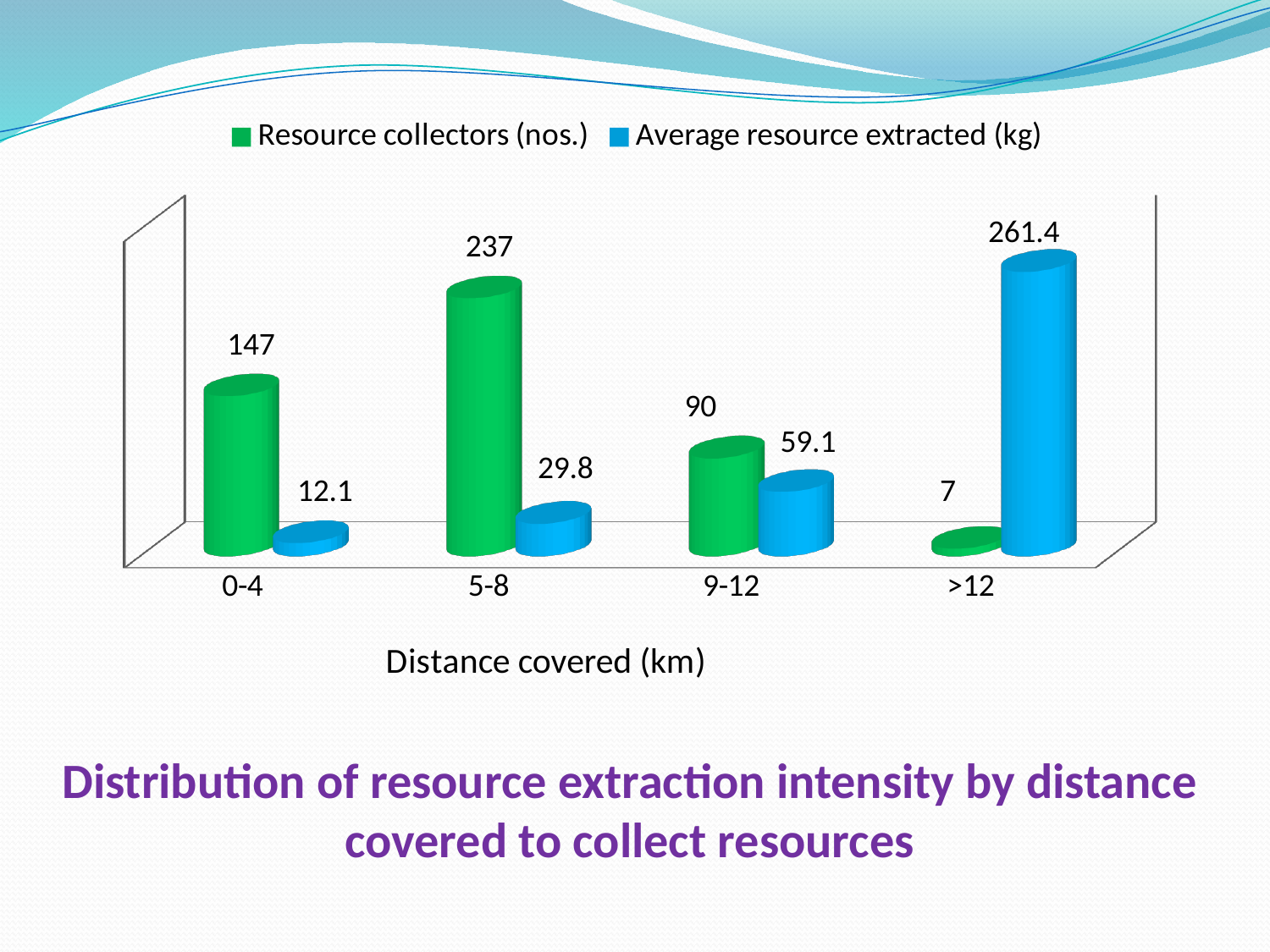
What kind of chart is shown on the slide? Bar chart What is the difference in the number of resource collectors between the 5-8 km and 0-4 km categories? 90 What is the average resource extracted (kg) for the >12 km distance category? 261.4 How many resource collectors are there for the 5-8 km distance category? 237 How many series does the legend list? 2 What is the average resource extracted (kg) for the 0-4 km distance category? 12.1 Which distance category has the highest number of resource collectors? 5-8 Which is larger for the 9-12 km category: the number of resource collectors or the average resource extracted (kg)? Resource collectors (nos.) What is the label of the x axis? Distance covered (km) What is the difference in average resource extracted (kg) between the >12 km and 9-12 km categories? 202.3 How many distance categories are shown on the x axis? 4 Which distance category has the lowest average resource extracted (kg)? 0-4